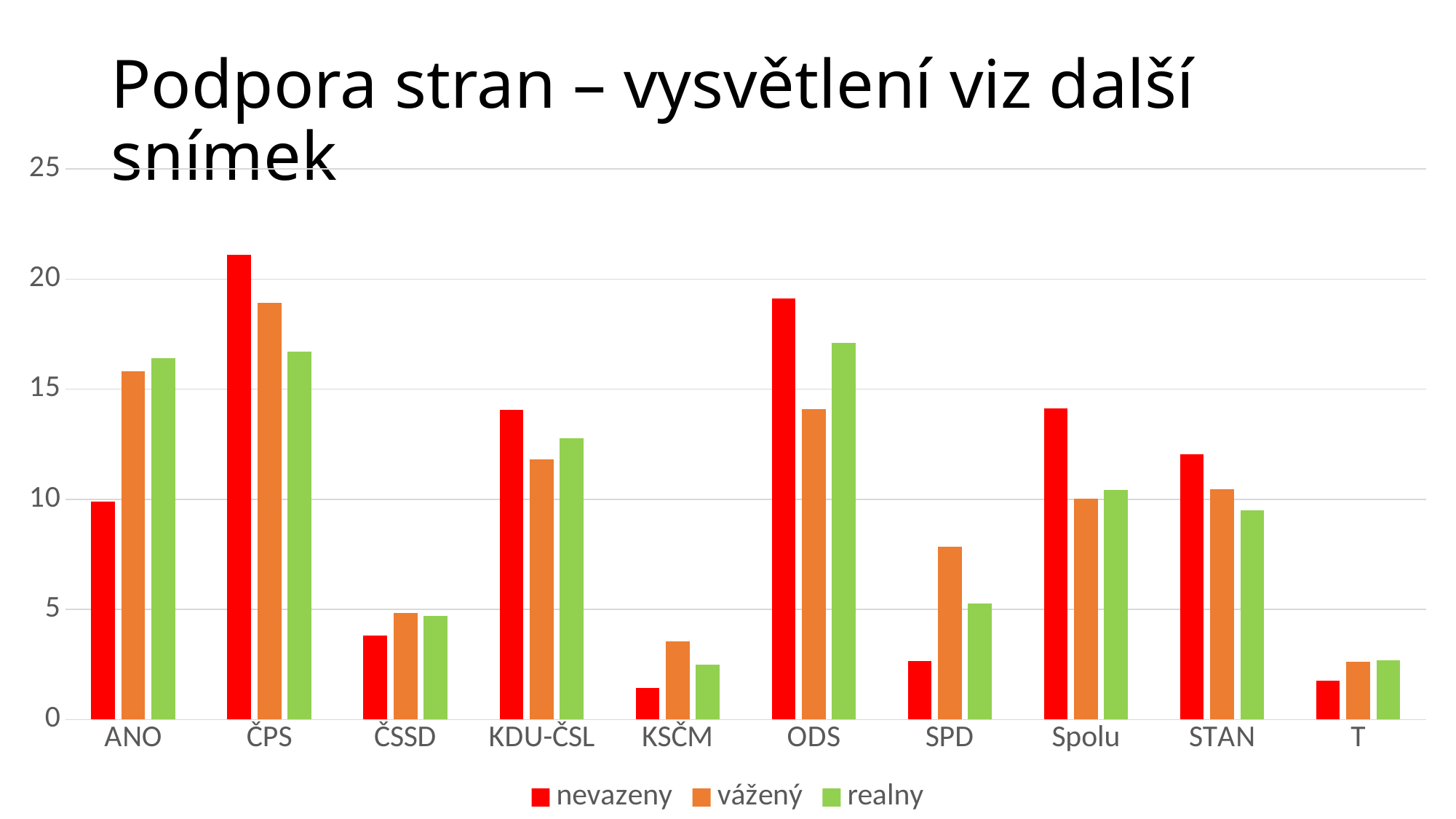
Which party has the highest vážený value? ČPS Is the nevazeny value for ODS greater or less than 20? less For ANO, which is larger: the nevazeny value or the realny value? realny Is the vážený value for KSČM greater or less than 5? less Is the nevazeny value for STAN greater or less than 10? greater Which party has the highest nevazeny value? ČPS How many series does the legend list? 3 What colour are the bars for the realny series? green How many parties (categories) are shown on the x axis? 10 What kind of chart is shown on the slide? bar chart For SPD, which is larger: the nevazeny value or the vážený value? vážený